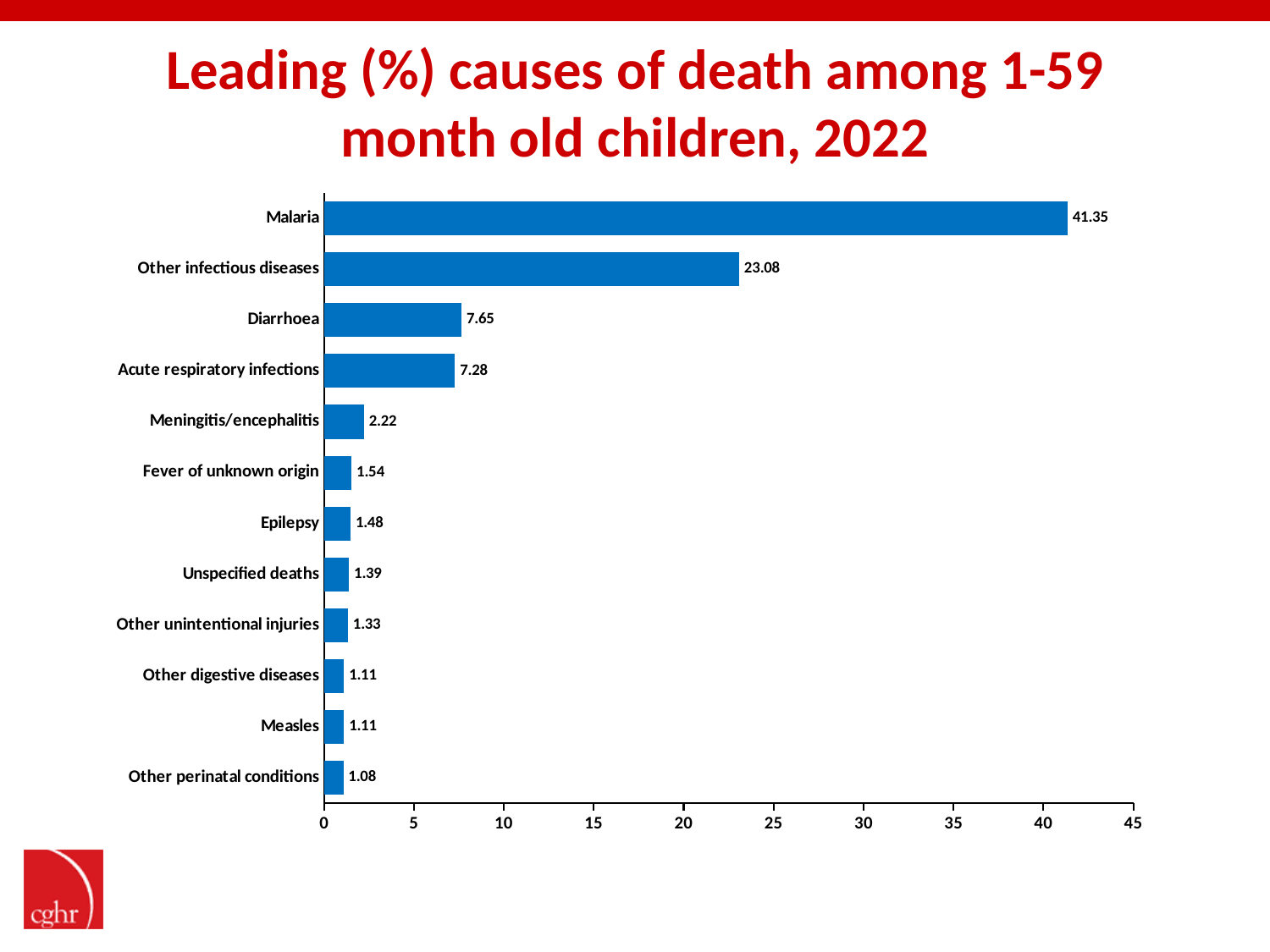
How many causes of death are shown in the chart? 12 Is the value for Other infectious diseases greater or less than 20? greater Which is larger, the value for Diarrhoea or the value for Acute respiratory infections? Diarrhoea What kind of chart is shown on the slide? Bar chart What is the title of the chart? Leading (%) causes of death among 1-59 month old children, 2022 What is the value for Malaria? 41.35 What is the difference between the values for Malaria and Other infectious diseases? 18.27 What is the value for Meningitis/encephalitis? 2.22 What is the value for Diarrhoea? 7.65 Which cause of death has the highest value? Malaria What is the value for Epilepsy? 1.48 Which cause of death has the lowest value? Other perinatal conditions